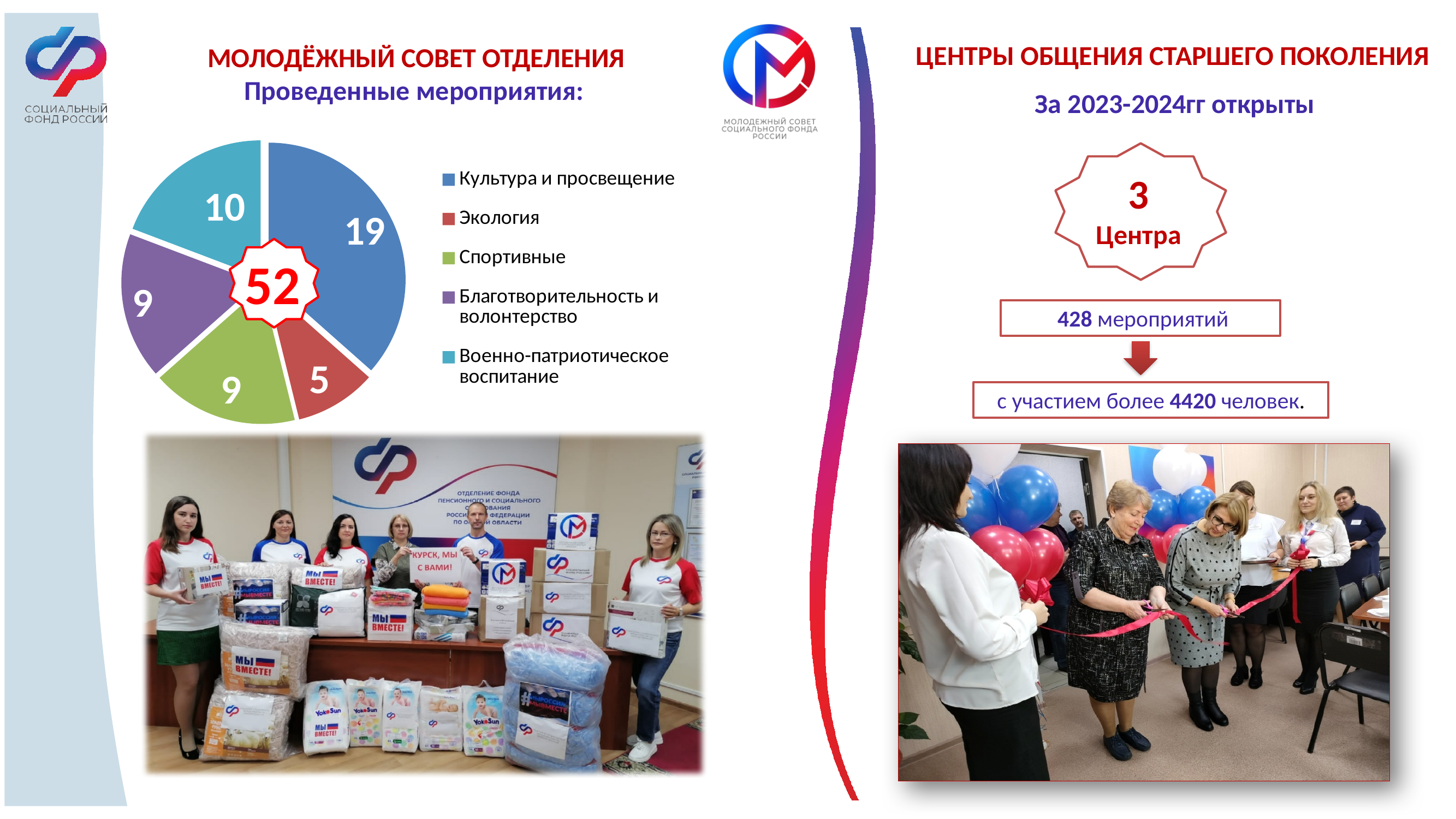
Which category has the largest slice in the pie chart? Культура и просвещение What total number is shown in the centre of the pie chart? 52 What kind of chart is shown on the slide? pie chart What is the difference between the values for Культура и просвещение and Экология? 14 Which is larger: the value for Военно-патриотическое воспитание or the value for Благотворительность и волонтерство? Военно-патриотическое воспитание How many entries does the legend of the pie chart list? 5 What is the value for Военно-патриотическое воспитание in the pie chart? 10 What is the value for Спортивные in the pie chart? 9 How many slices does the pie chart have? 5 What is the value for Экология in the pie chart? 5 Which category has the smallest slice in the pie chart? Экология What is the value for Культура и просвещение in the pie chart? 19